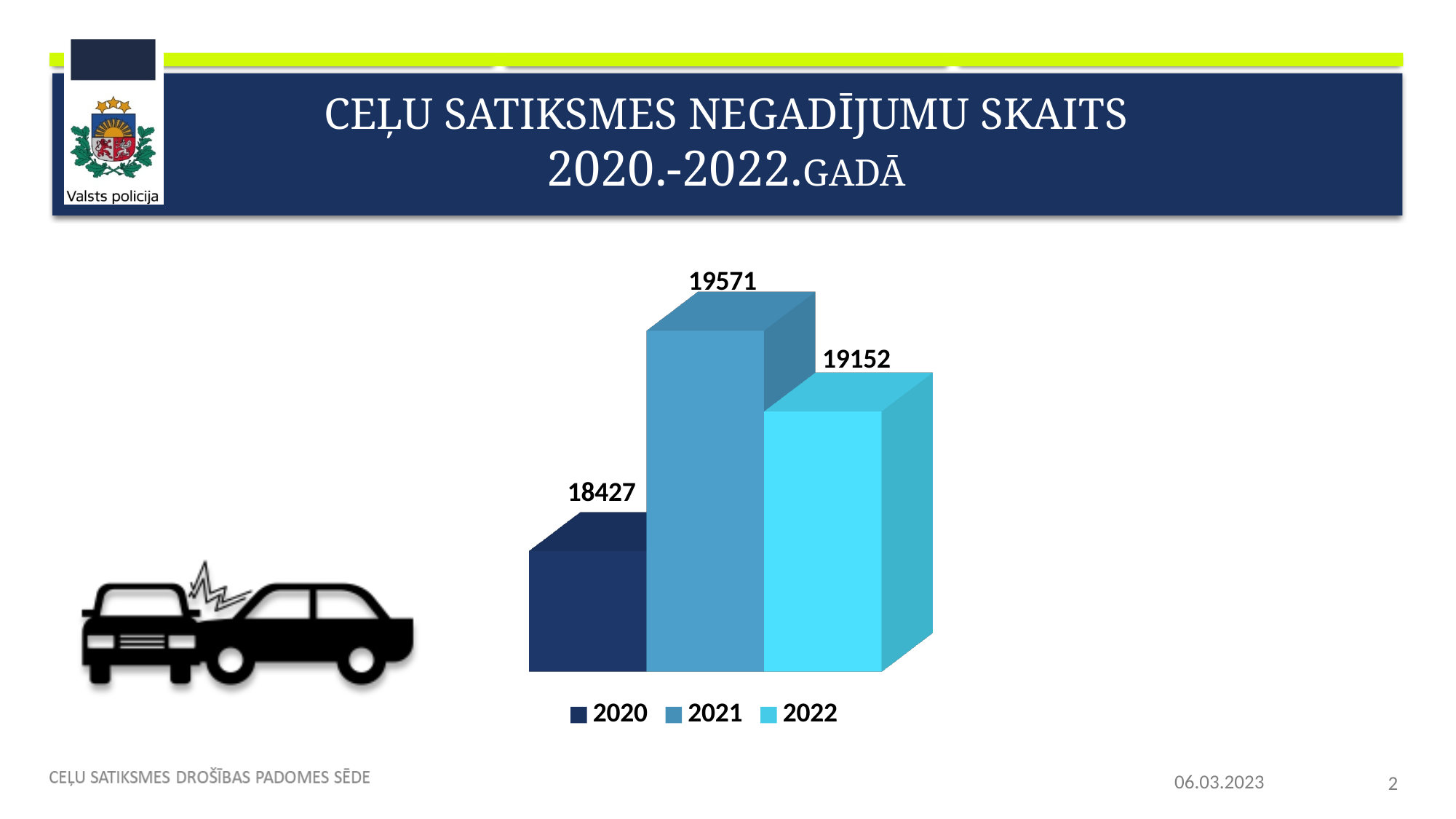
Which is larger, the value for 2022 or the value for 2020? 2022 How many bars are shown in the chart? 3 What is the value for 2021? 19571 What is the difference between the values for 2021 and 2022? 419 What is the difference between the values for 2021 and 2020? 1144 What is the title of the slide containing the chart? CEĻU SATIKSMES NEGADĪJUMU SKAITS 2020.-2022.GADĀ What kind of chart is shown on the slide? bar chart What is the value for 2020? 18427 Which year has the highest value? 2021 How many entries does the legend list? 3 Which year has the lowest value? 2020 What is the value for 2022? 19152